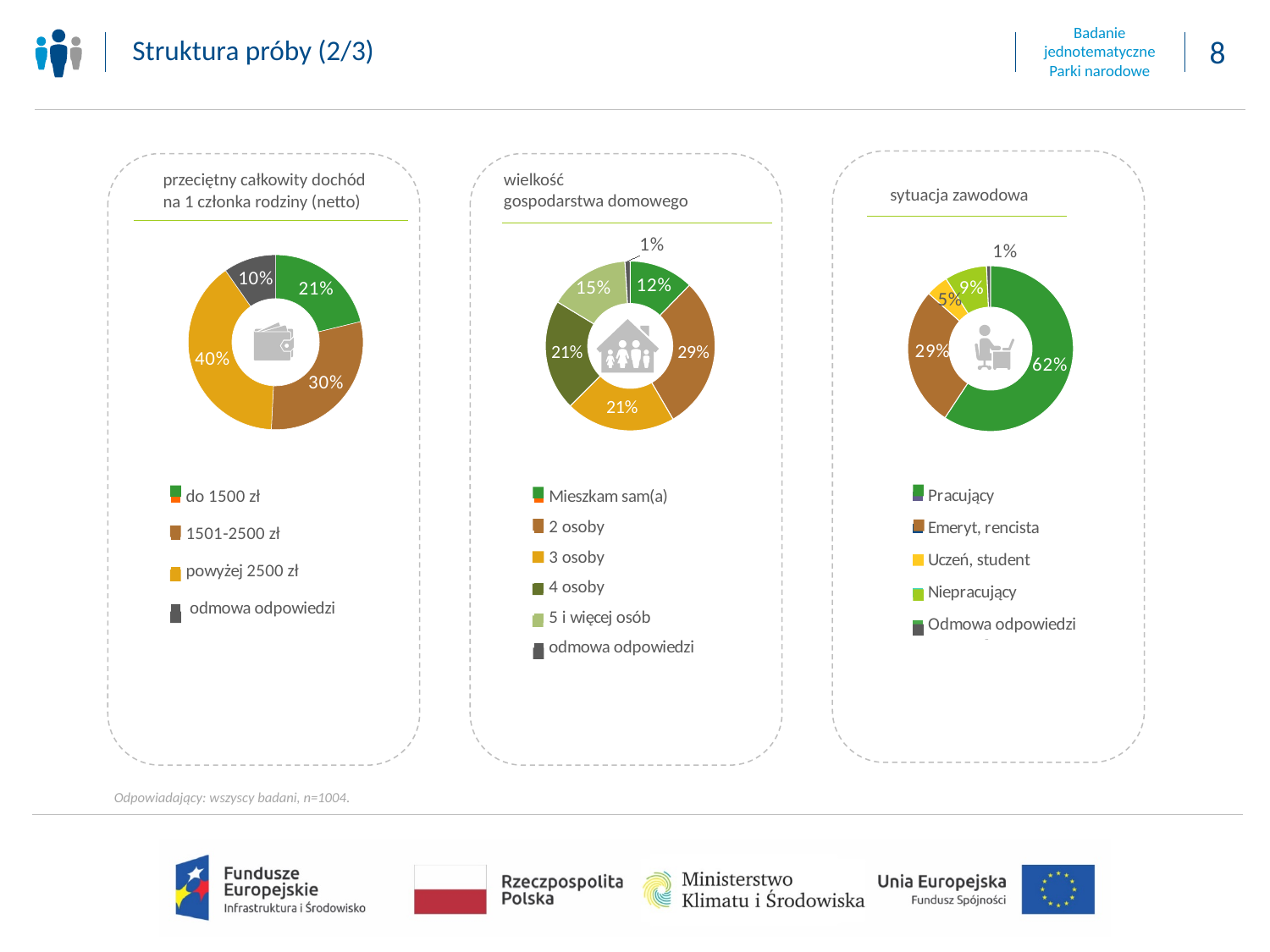
How many categories does the legend of the chart titled 'wielkość gospodarstwa domowego' list? 6 In the chart titled 'przeciętny całkowity dochód na 1 członka rodziny (netto)', what percentage is shown for 'powyżej 2500 zł'? 40% In the chart titled 'sytuacja zawodowa', what percentage is shown for 'Pracujący'? 62% In the chart titled 'przeciętny całkowity dochód na 1 członka rodziny (netto)', which category has the smallest share? odmowa odpowiedzi What type of chart is used for 'sytuacja zawodowa'? Donut (pie) chart In the chart titled 'sytuacja zawodowa', what percentage is shown for 'Emeryt, rencista'? 29% In the chart titled 'wielkość gospodarstwa domowego', what percentage is shown for '5 i więcej osób'? 15% In the chart titled 'wielkość gospodarstwa domowego', what percentage is shown for '2 osoby'? 29% In the chart titled 'sytuacja zawodowa', which is larger: 'Pracujący' or 'Emeryt, rencista'? Pracujący In the chart titled 'wielkość gospodarstwa domowego', which category has the largest share? 2 osoby In the chart titled 'przeciętny całkowity dochód na 1 członka rodziny (netto)', what is the difference in percentage points between 'powyżej 2500 zł' and '1501-2500 zł'? 10 In the chart titled 'przeciętny całkowity dochód na 1 członka rodziny (netto)', what percentage is shown for 'do 1500 zł'? 21%